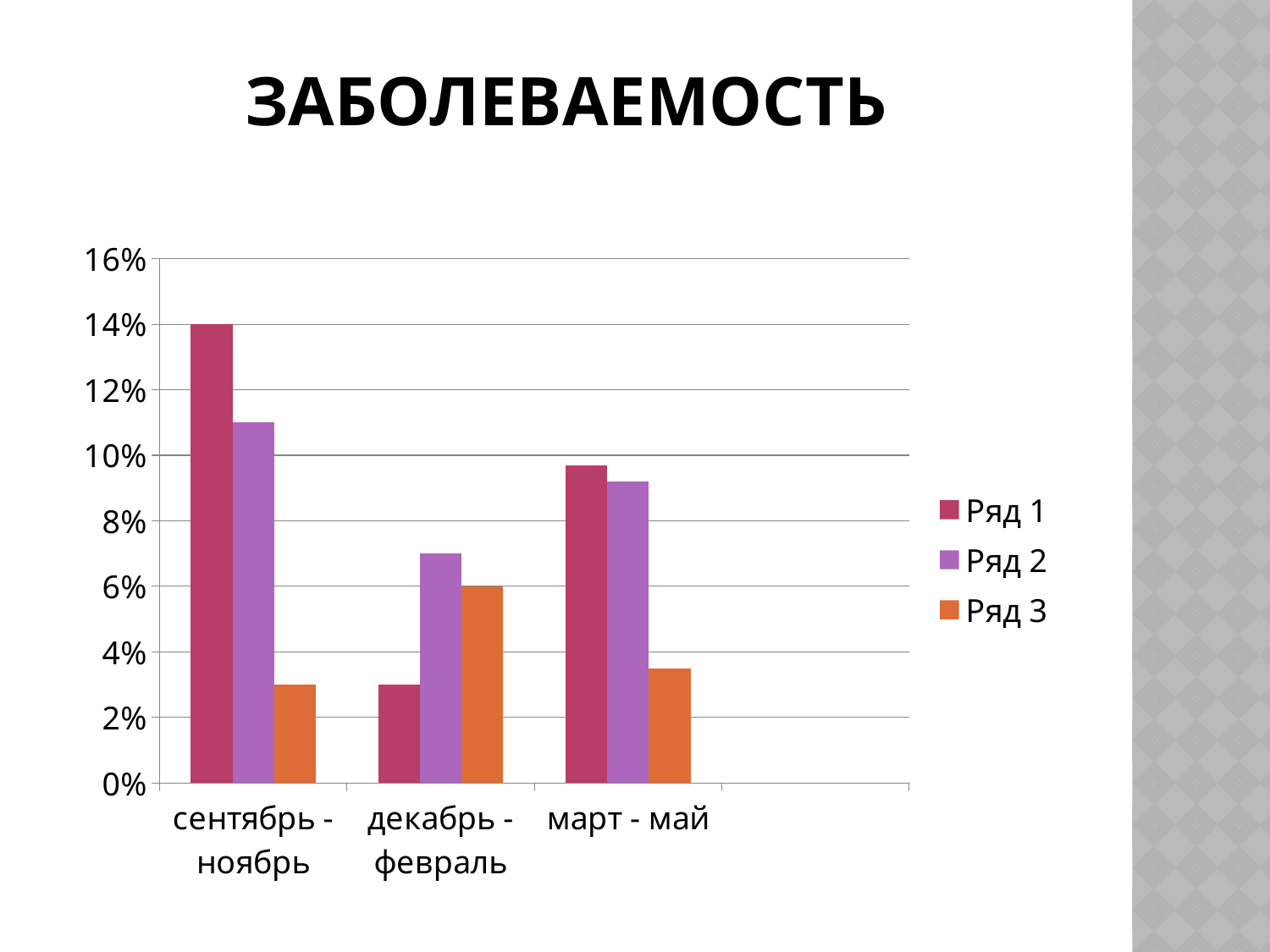
In сентябрь - ноябрь, which is larger: Ряд 1 or Ряд 3? Ряд 1 How many periods are shown on the x axis? 3 What kind of chart is shown on the slide? bar chart Which period has the lowest value for Ряд 1? декабрь - февраль Which period has the highest value for Ряд 1? сентябрь - ноябрь What is the value for Ряд 3 in декабрь - февраль? 6% How many series does the legend list? 3 Which period has the lowest value for Ряд 2? декабрь - февраль Which period has the highest value for Ряд 3? декабрь - февраль Is the value for Ряд 3 in март - май greater or less than 4%? less What is the value for Ряд 1 in сентябрь - ноябрь? 14% Is the value for Ряд 2 in сентябрь - ноябрь greater or less than 10%? greater